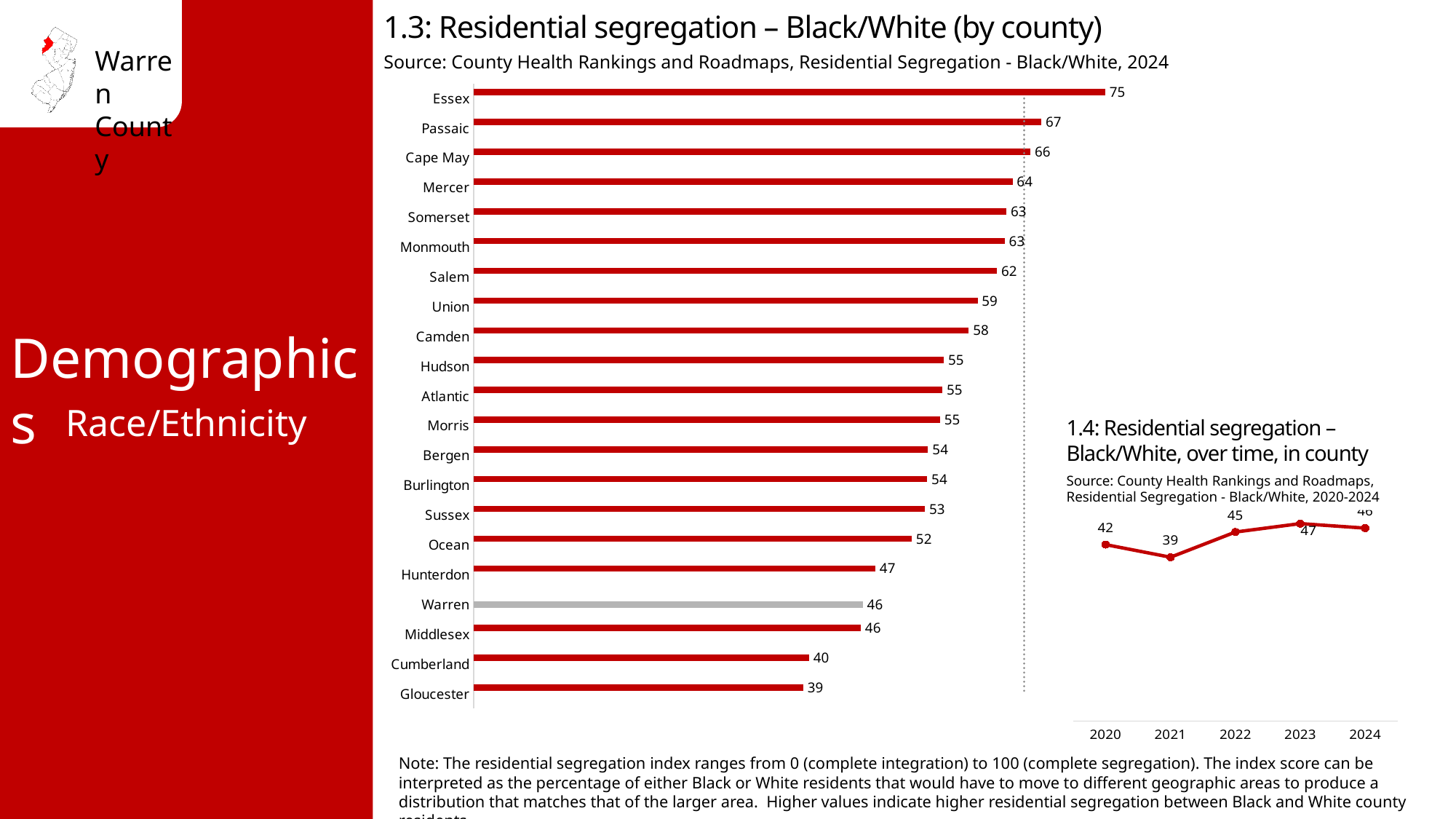
In chart 1.3 (Residential segregation – Black/White by county), what is the value for Essex? 75 In chart 1.3 (Residential segregation – Black/White by county), what is the difference between the values for Essex and Gloucester? 36 In chart 1.3 (Residential segregation – Black/White by county), which has a larger value, Passaic or Mercer? Passaic In chart 1.3 (Residential segregation – Black/White by county), which county's bar is shown in grey instead of red? Warren In chart 1.3 (Residential segregation – Black/White by county), which county has the lowest value? Gloucester In chart 1.3 (Residential segregation – Black/White by county), which county has the highest value? Essex What kind of chart is chart 1.4 (Residential segregation – Black/White over time in county)? Line chart In chart 1.3 (Residential segregation – Black/White by county), how many counties are shown? 21 In chart 1.4 (Residential segregation – Black/White over time in county), what is the value for 2023? 47 In chart 1.4 (Residential segregation – Black/White over time in county), what is the value for 2021? 39 In chart 1.3 (Residential segregation – Black/White by county), what is the value for Warren? 46 In chart 1.3 (Residential segregation – Black/White by county), what is the value for Cumberland? 40